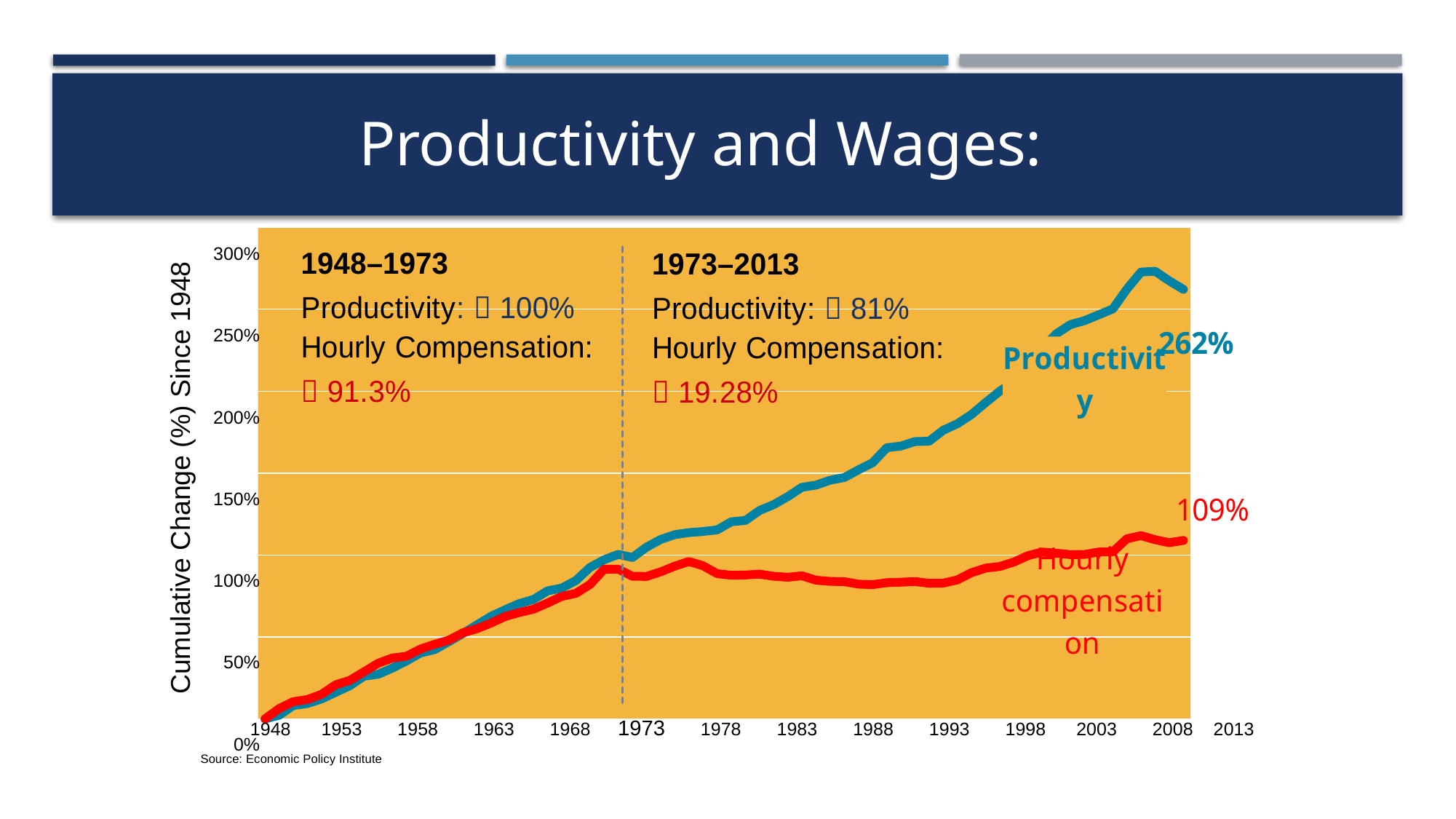
Is the Productivity value around 1993 greater or less than 150%? greater Does the Productivity line generally rise or fall from 1948 to 2008? rise What is the title of the vertical axis? Cumulative Change (%) Since 1948 What is the labelled end value of the Hourly compensation line? 109% What kind of chart is shown on the slide? line chart What is the difference between the labelled end values of Productivity (262%) and Hourly compensation (109%)? 153 percentage points According to the annotation, by how much did Hourly Compensation increase from 1973 to 2013? 19.28% According to the annotation, by how much did Productivity increase from 1948 to 1973? 100% How many data series are plotted on the chart? 2 Is the Hourly compensation value around 1988 greater or less than 150%? less Which series ends at a higher value, Productivity or Hourly compensation? Productivity What is the labelled end value of the Productivity line? 262%